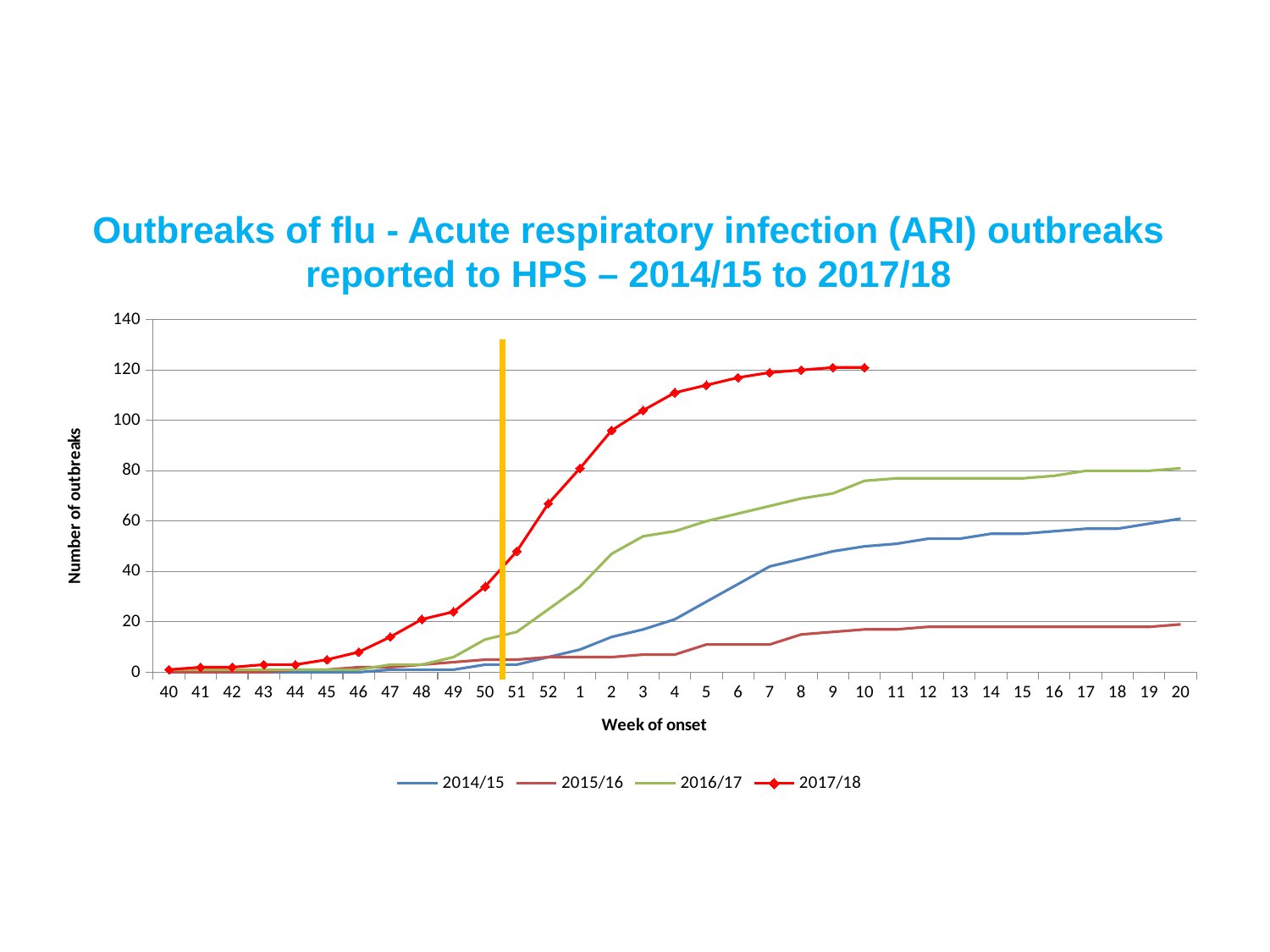
What kind of chart is shown on the slide? line chart Which series reaches the highest number of outbreaks on the chart? 2017/18 Is the value for 2015/16 at week 20 greater or less than 40? less At week 20, which series has the larger value, 2014/15 or 2015/16? 2014/15 Which series has the lowest value at week 20? 2015/16 Does the 2017/18 series rise or fall from week 40 to week 10? rise How many series does the legend list? 4 How many weeks of onset are shown along the x axis? 33 What is the title of the x axis? Week of onset Is the value for 2017/18 at week 10 greater or less than 100? greater Is the value for 2016/17 at week 20 greater or less than 100? less